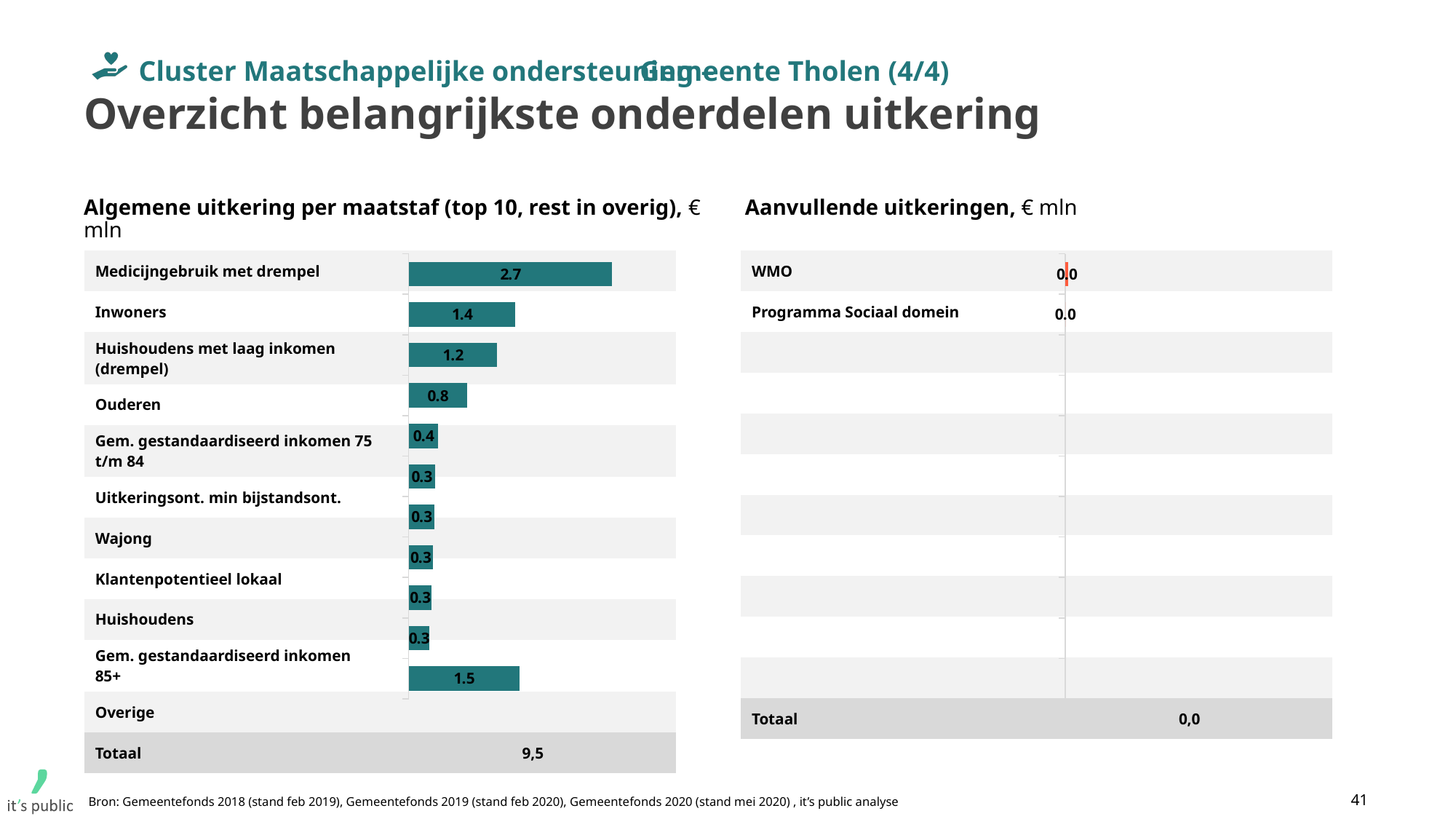
In the chart 'Algemene uitkering per maatstaf', what is the value for Inwoners? 1.4 How many categories (excluding Totaal) are shown in the chart 'Algemene uitkering per maatstaf'? 11 In the chart 'Algemene uitkering per maatstaf', which is larger: Huishoudens met laag inkomen (drempel) or Ouderen? Huishoudens met laag inkomen (drempel) In the chart 'Algemene uitkering per maatstaf', what is the value for Ouderen? 0.8 In the chart 'Aanvullende uitkeringen', what is the Totaal shown? 0,0 In the chart 'Algemene uitkering per maatstaf', what is the Totaal shown? 9,5 What type of chart is 'Algemene uitkering per maatstaf'? Bar chart In the chart 'Algemene uitkering per maatstaf', what is the difference between Medicijngebruik met drempel and Inwoners? 1.3 In the chart 'Algemene uitkering per maatstaf', which category has the highest value? Medicijngebruik met drempel In the chart 'Algemene uitkering per maatstaf', what is the value for Overige? 1.5 In the chart 'Aanvullende uitkeringen', what is the value for WMO? 0.0 In the chart 'Algemene uitkering per maatstaf', what is the value for Medicijngebruik met drempel? 2.7